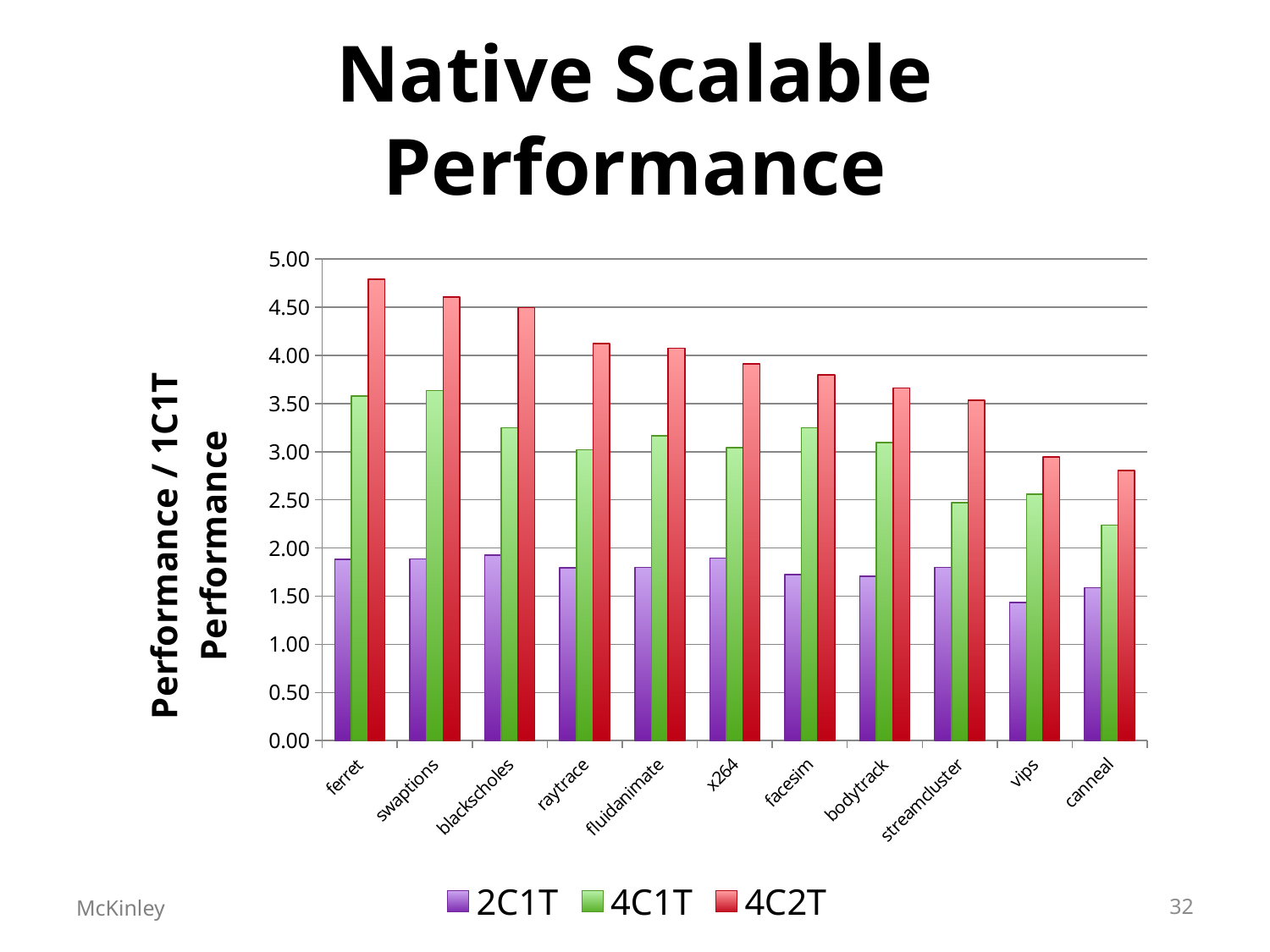
Do the 4C2T values generally rise or fall from left to right across the benchmarks? fall Is the 4C1T value for canneal greater or less than 2.50? less Is the 2C1T value for vips greater or less than 1.50? less Is the 4C2T value for x264 greater or less than 4.00? less Which benchmark has the highest 4C2T value? ferret Which benchmark has the lowest 2C1T value? vips What kind of chart is shown on the slide? bar chart Which benchmark has the lowest 4C1T value? canneal How many benchmark categories are shown on the x axis? 11 Which is larger, the 4C2T value for ferret or the 4C2T value for canneal? ferret How many series does the legend list? 3